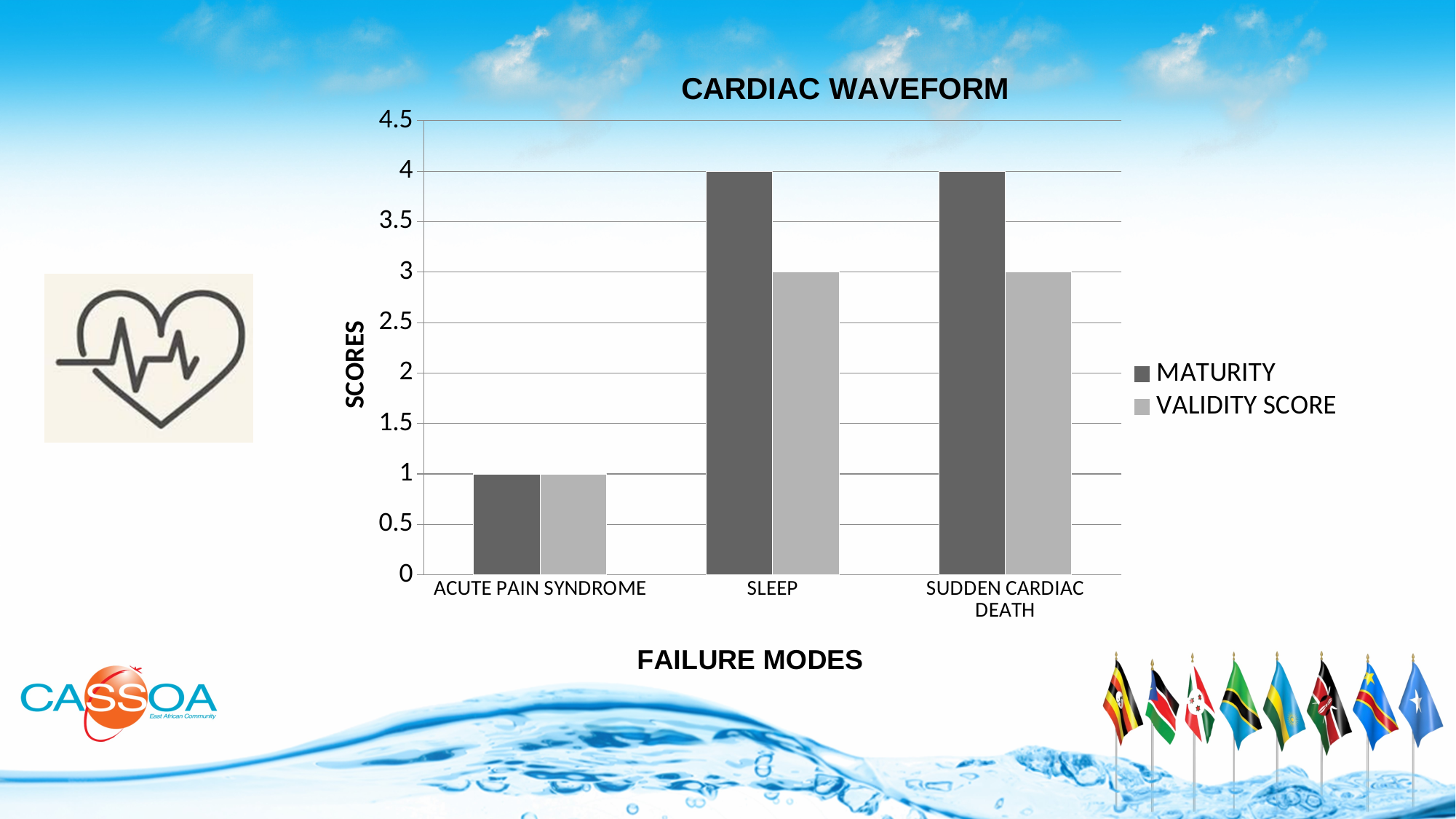
What is the difference between the MATURITY and VALIDITY SCORE values for SLEEP? 1 How many failure mode categories are shown on the x axis? 3 Is the MATURITY value for SLEEP greater or less than 2? greater What is the label of the y axis? SCORES What is the MATURITY value for ACUTE PAIN SYNDROME? 1 How many series does the legend list? 2 What type of chart is shown on the slide? bar chart What is the MATURITY value for SLEEP? 4 What is the VALIDITY SCORE for SUDDEN CARDIAC DEATH? 3 What is the title of the chart? CARDIAC WAVEFORM Which category has the lowest VALIDITY SCORE? ACUTE PAIN SYNDROME Which is larger for SUDDEN CARDIAC DEATH, the MATURITY value or the VALIDITY SCORE? MATURITY